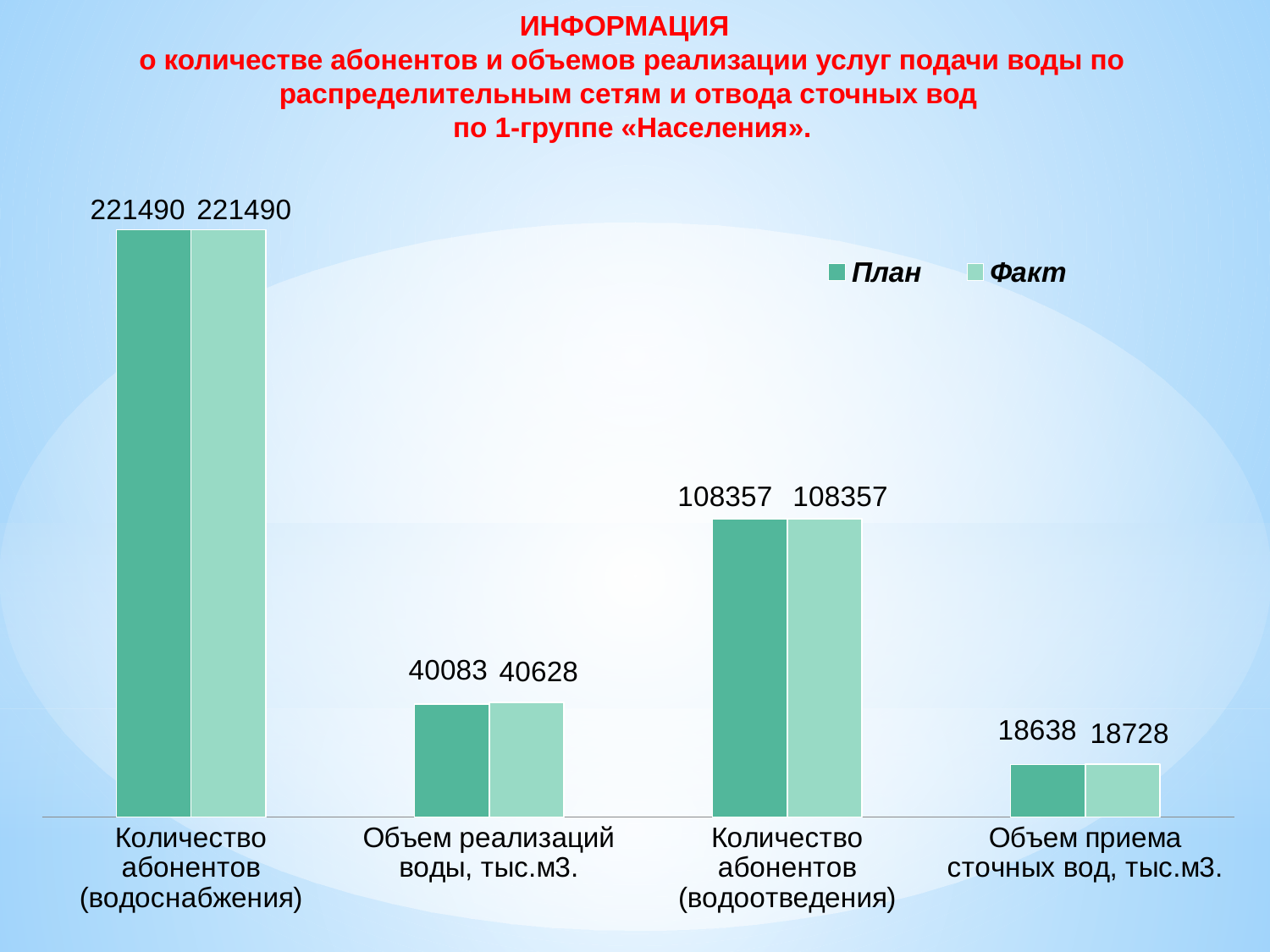
What is the План value for Количество абонентов (водоотведения)? 108357 Which category has the lowest Факт value? Объем приема сточных вод, тыс.м3. What is the Факт value for Объем реализаций воды, тыс.м3.? 40628 What is the difference between the Факт and План values for Объем реализаций воды, тыс.м3.? 545 Which is larger for Объем реализаций воды, тыс.м3.: the План value or the Факт value? Факт What kind of chart is shown on the slide? Bar chart How many series does the legend list? 2 What is the План value for Количество абонентов (водоснабжения)? 221490 What is the Факт value for Объем приема сточных вод, тыс.м3.? 18728 How many categories are shown on the x axis? 4 Which category has the highest План value? Количество абонентов (водоснабжения) What is the difference between the Факт and План values for Объем приема сточных вод, тыс.м3.? 90